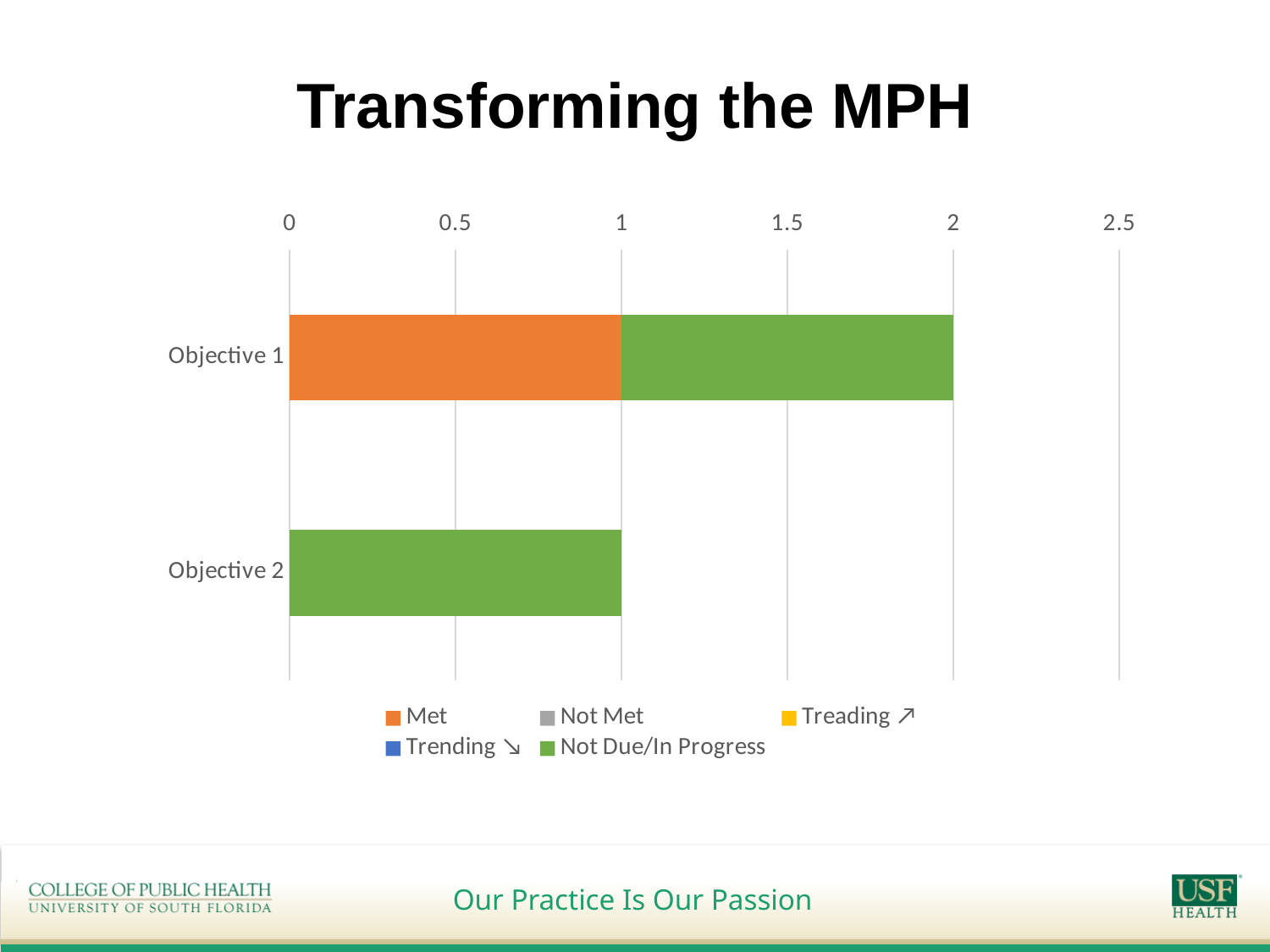
What is the Met value for Objective 1? 1 What is the difference between the total bar lengths of Objective 1 and Objective 2? 1 What is the total length of the stacked bar for Objective 1? 2 What is the Not Due/In Progress value for Objective 2? 1 What is the Not Due/In Progress value for Objective 1? 1 How many series does the chart's legend list? 5 What kind of chart is shown on the slide? Stacked bar chart Is the total bar for Objective 1 greater or less than 1.5? greater Which objective has the longer total bar? Objective 1 Which series is shown in orange in the legend? Met How many objectives (categories) are plotted on the chart? 2 What is the total length of the stacked bar for Objective 2? 1